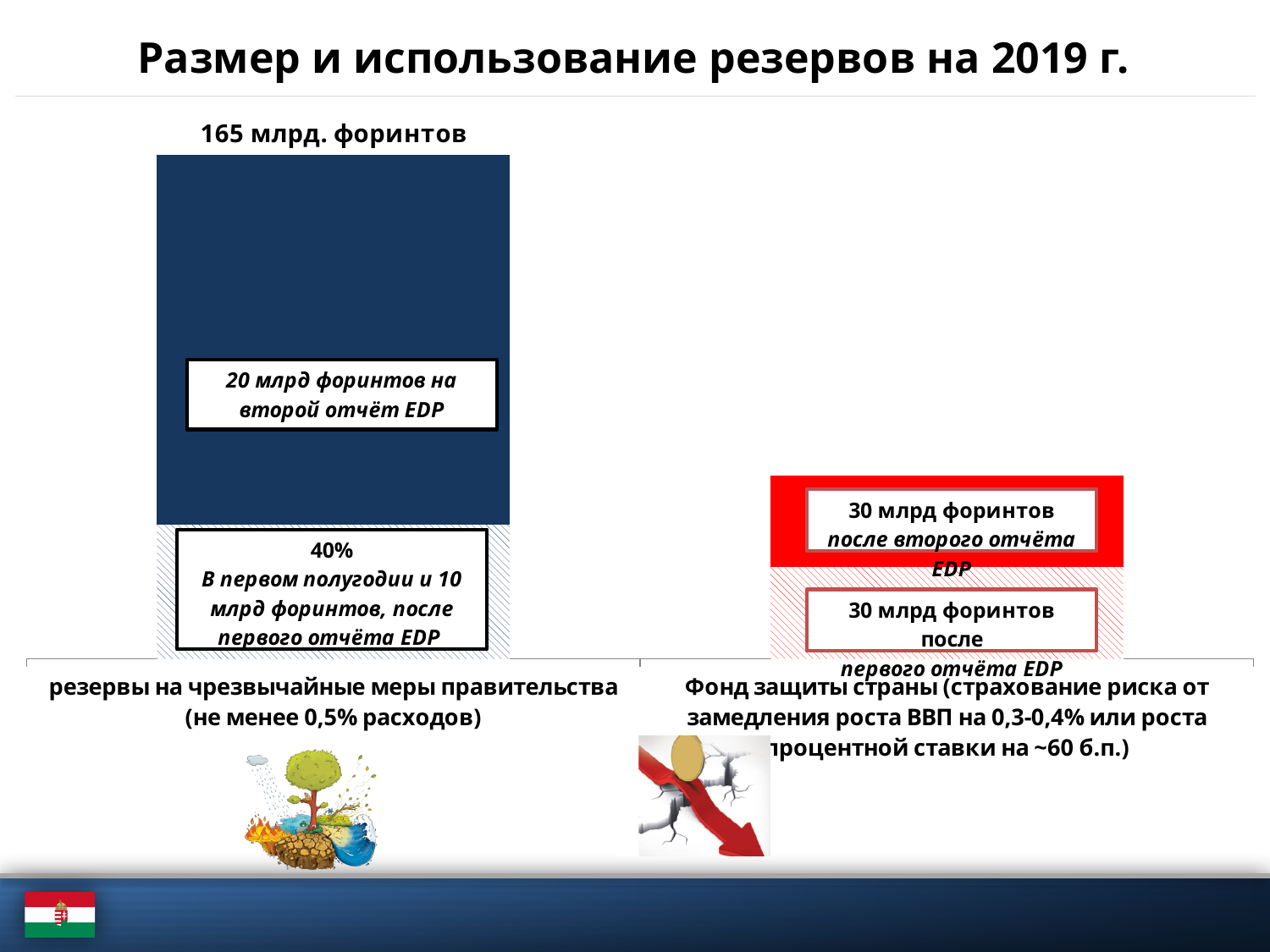
What colour is the upper segment of the 'Фонд защиты страны' bar? Red What amount is labelled in the red segment of the 'Фонд защиты страны' bar (после второго отчёта EDP)? 30 млрд форинтов What is the total of the two labelled segments of the 'Фонд защиты страны' bar? 60 млрд форинтов According to the label in the dark blue segment of the left bar, how much is allocated for the second EDP report? 20 млрд форинтов Which bar is taller: 'резервы на чрезвычайные меры правительства' or 'Фонд защиты страны'? резервы на чрезвычайные меры правительства Which category has the lowest bar in the chart? Фонд защиты страны What is the title of the chart on the slide? Размер и использование резервов на 2019 г. Which category has the highest bar in the chart? резервы на чрезвычайные меры правительства What is the total value shown above the bar for 'резервы на чрезвычайные меры правительства'? 165 млрд. форинтов What kind of chart is shown on the slide? Bar chart How many categories (bars) are shown in the chart? 2 What amount is labelled in the hatched segment of the 'Фонд защиты страны' bar (после первого отчёта EDP)? 30 млрд форинтов